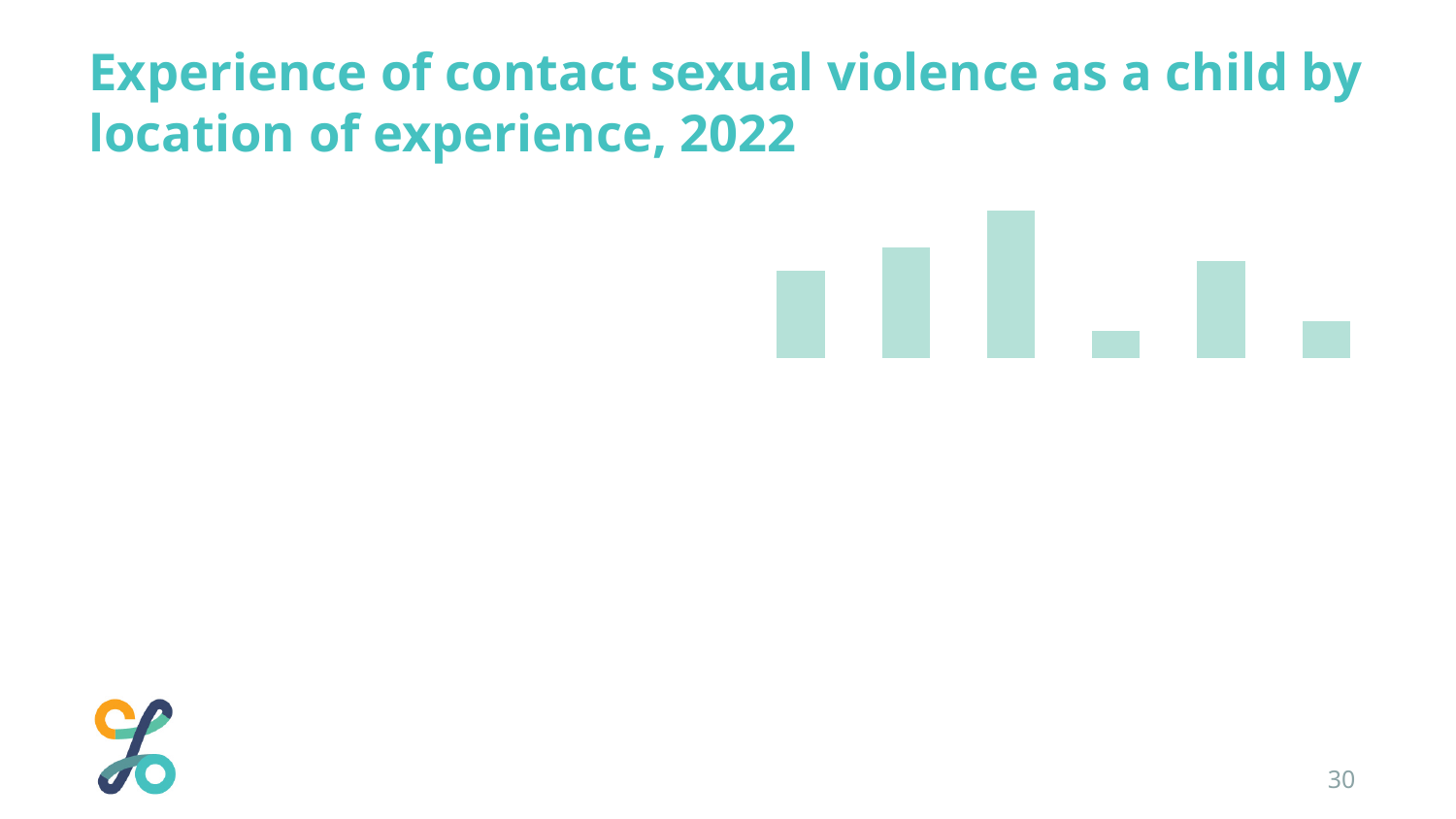
Counting from the left, which bar in the chart is the tallest? the third bar Is the first bar from the left taller or shorter than the second bar? shorter Is the fourth bar from the left taller or shorter than the third bar? shorter What kind of chart is shown on the slide? bar chart How many bars does the chart contain? 6 What is the title of the slide containing the chart? Experience of contact sexual violence as a child by location of experience, 2022 Is the fifth bar from the left taller or shorter than the sixth bar? taller Counting from the left, which bar in the chart is the shortest? the fourth bar Does the chart display any data labels or axis values? No